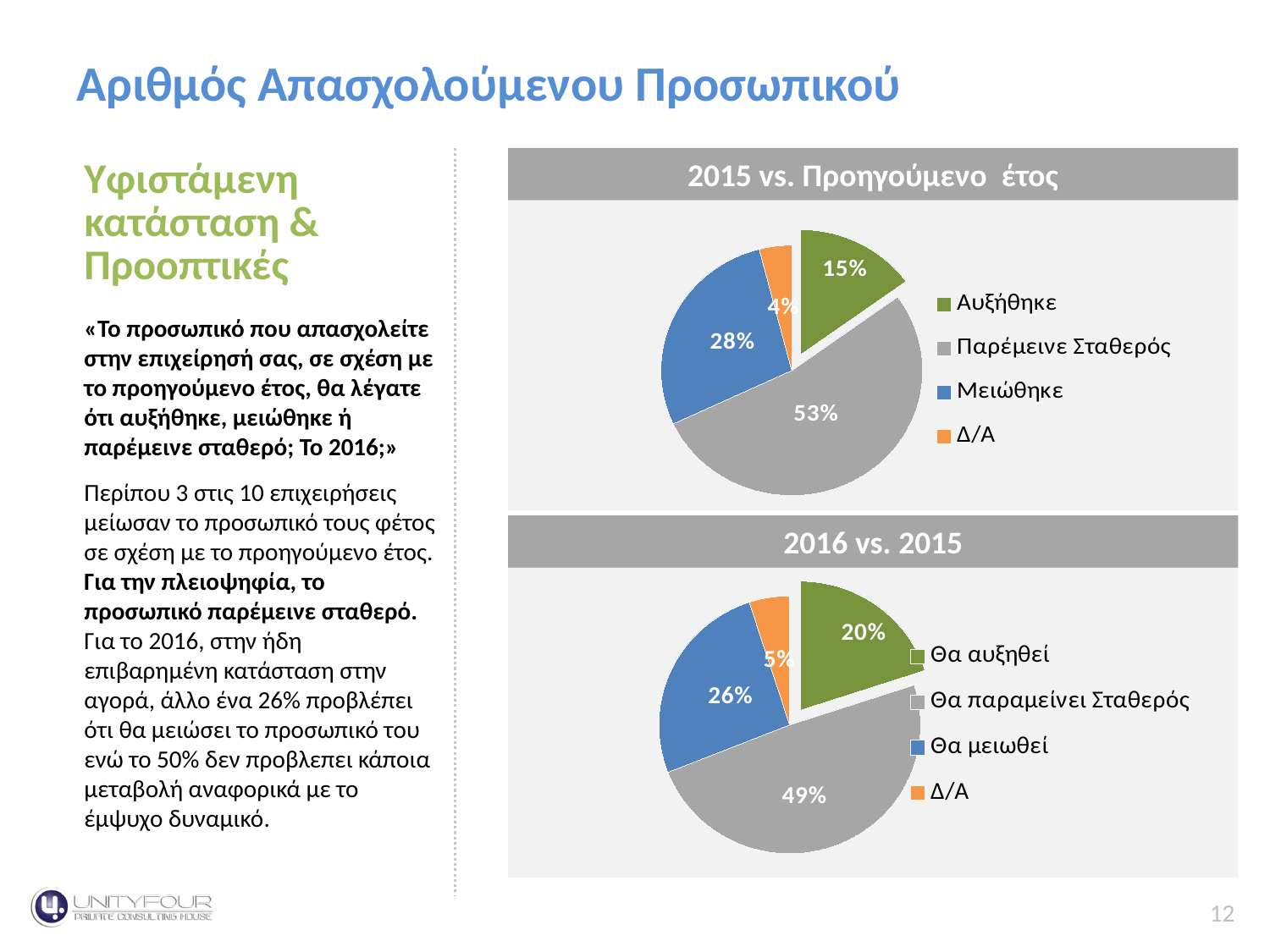
In the chart titled "2015 vs. Προηγούμενο έτος", which category has the largest slice? Παρέμεινε Σταθερός In the chart titled "2015 vs. Προηγούμενο έτος", what is the difference between the Παρέμεινε Σταθερός and Μειώθηκε percentages? 25% How many categories does the legend of the chart titled "2015 vs. Προηγούμενο έτος" list? 4 What type of chart is the chart titled "2016 vs. 2015"? Pie chart In the chart titled "2015 vs. Προηγούμενο έτος", what percentage is shown for Αυξήθηκε? 15% In the chart titled "2016 vs. 2015", what is the difference between the Θα μειωθεί and Θα αυξηθεί percentages? 6% In the chart titled "2015 vs. Προηγούμενο έτος", which category has the smallest slice? Δ/Α In the chart titled "2016 vs. 2015", what colour is the Θα μειωθεί slice? Blue In the chart titled "2015 vs. Προηγούμενο έτος", what percentage is shown for Μειώθηκε? 28% In the chart titled "2016 vs. 2015", which is larger, Θα αυξηθεί or Θα μειωθεί? Θα μειωθεί In the chart titled "2016 vs. 2015", what percentage is shown for Θα παραμείνει Σταθερός? 49% In the chart titled "2016 vs. 2015", what percentage is shown for Δ/Α? 5%